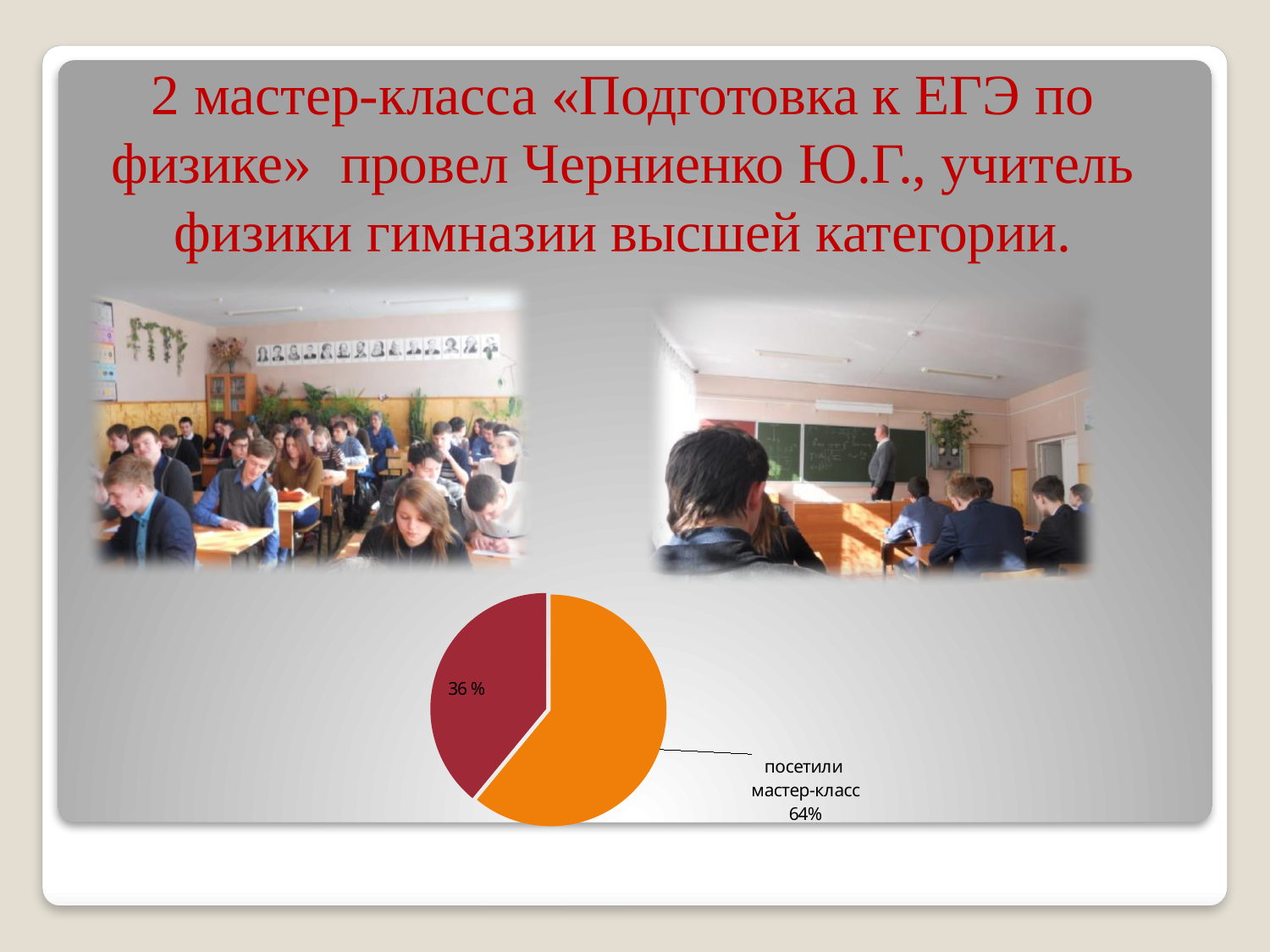
What colour is the slice labelled "посетили мастер-класс"? orange Does the pie chart have a legend? no Which slice of the pie chart is the largest? посетили мастер-класс (64%) What percentage is printed on the dark red slice of the pie chart? 36 % Which slice of the pie chart is the smallest? the dark red slice (36 %) What is the difference in percentage points between the "посетили мастер-класс" slice and the dark red slice? 28 Is the share for "посетили мастер-класс" greater or less than 50%? greater Which slice of the pie chart is larger: the orange slice or the dark red slice? the orange slice What share of the pie is labelled "посетили мастер-класс"? 64% How many slices does the pie chart have? 2 What kind of chart is shown on the slide? pie chart